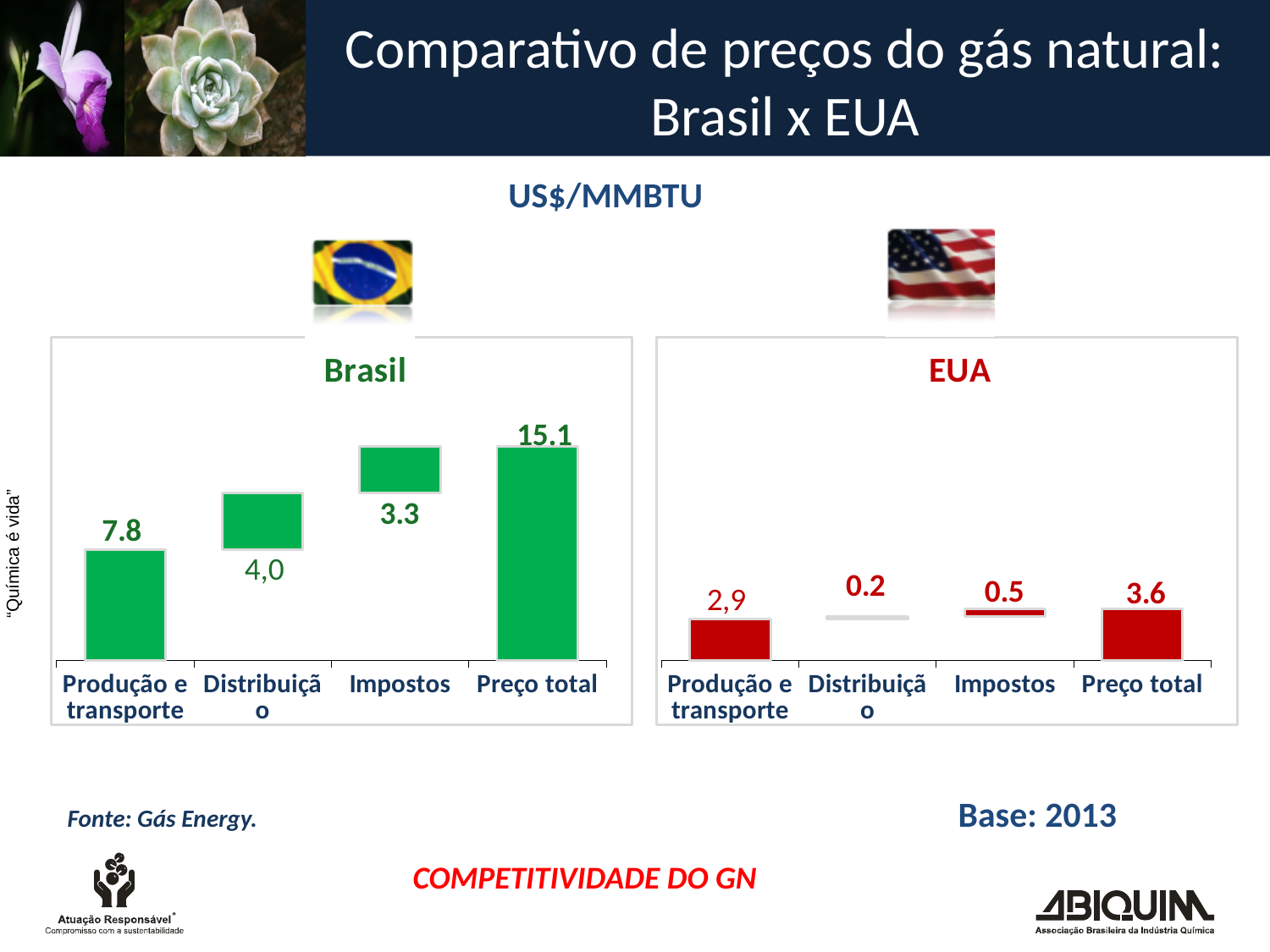
In the Brasil chart, what is the value for Distribuição? 4,0 In the EUA chart, what is the value for Distribuição? 0.2 In the Brasil chart, what is the value for Impostos? 3.3 In the EUA chart, what is the value for Preço total? 3.6 In the Brasil chart, which category has the highest value? Preço total What kind of chart is the Brasil chart? Bar chart How many categories are shown on the x axis of the EUA chart? 4 Which is larger: Impostos in the Brasil chart or Impostos in the EUA chart? Impostos in the Brasil chart What is the difference between the Preço total in the Brasil chart (15.1) and the Preço total in the EUA chart (3.6)? 11.5 In the Brasil chart, what is the value for Produção e transporte? 7.8 In the EUA chart, which category has the lowest value? Distribuição In the Brasil chart, what is the difference between Produção e transporte and Impostos? 4.5